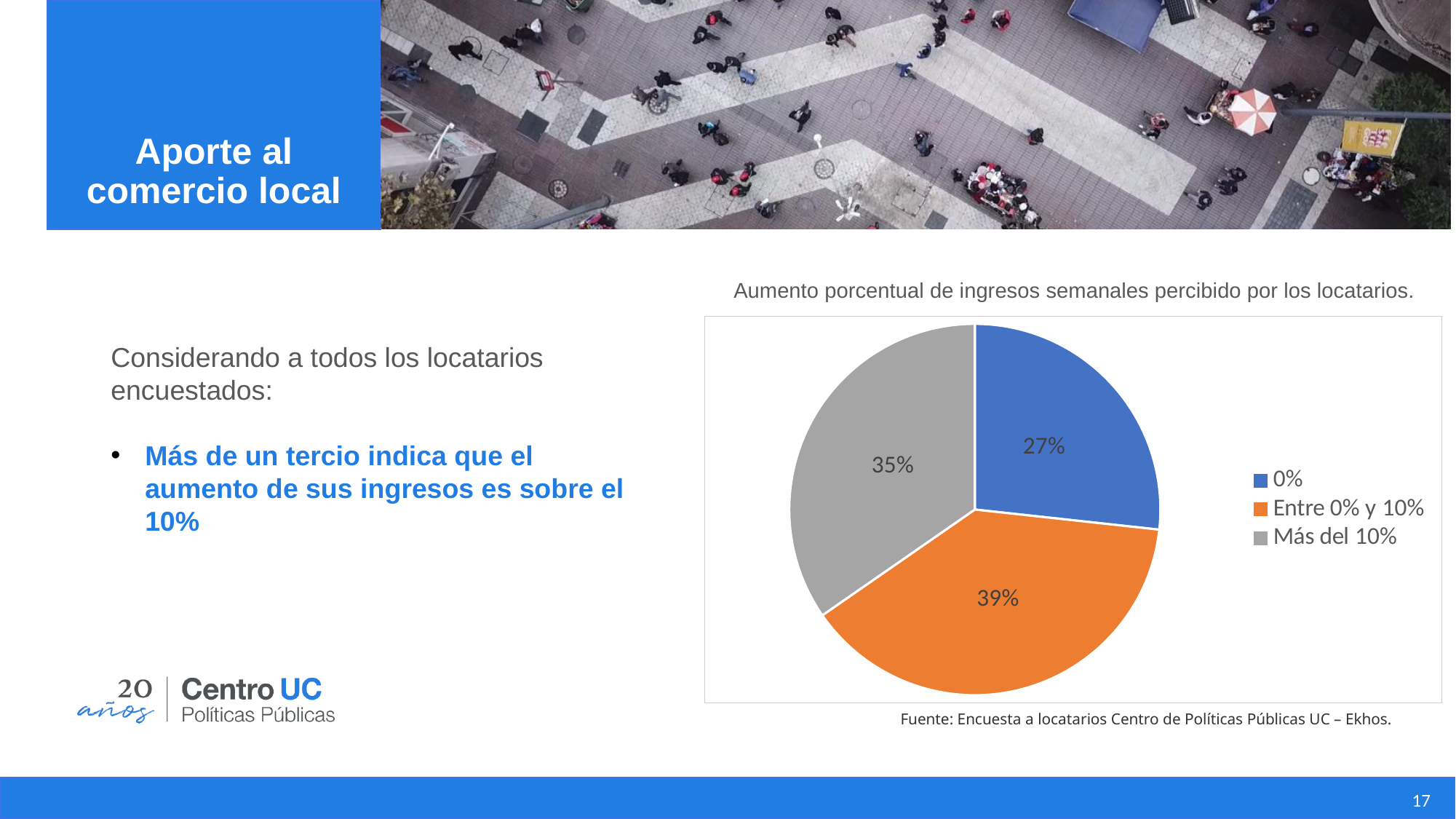
Which is larger: the share for "Más del 10%" or the share for "0%"? Más del 10% Which category has the smallest slice of the pie? 0% What share of the pie corresponds to "Más del 10%"? 35% What colour is the slice for "Más del 10%"? Gray What share of the pie corresponds to "0%"? 27% How many categories does the pie chart have? 3 What share of the pie corresponds to "Entre 0% y 10%"? 39% What type of chart is shown on the slide? Pie chart What is the title of the chart? Aumento porcentual de ingresos semanales percibido por los locatarios. Which category has the largest slice of the pie? Entre 0% y 10% What is the difference between the shares for "Entre 0% y 10%" and "Más del 10%"? 4% What is the difference between the shares for "Entre 0% y 10%" and "0%"? 12%